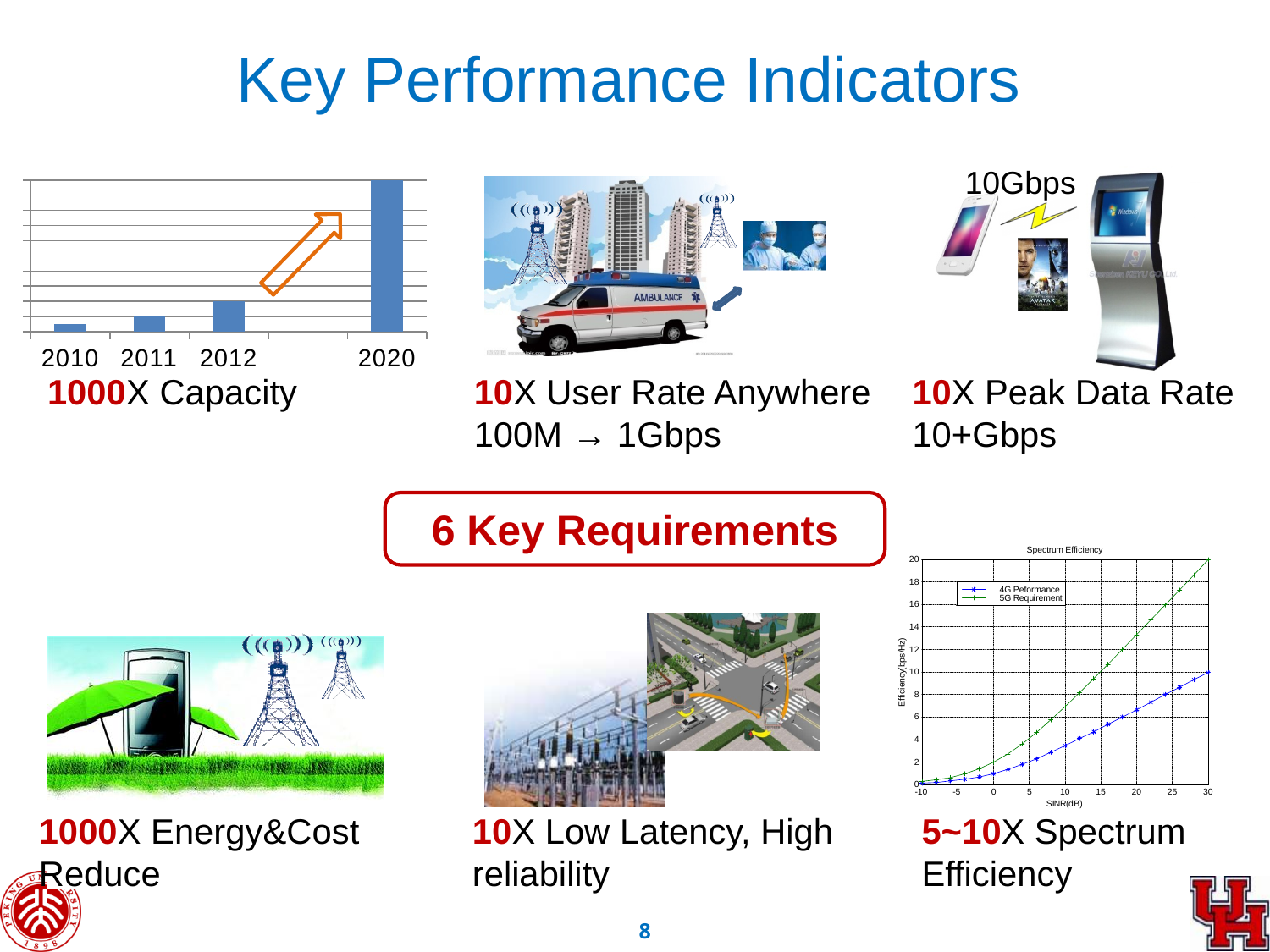
What is the x-axis label of the Spectrum Efficiency chart? SINR(dB) What are the two series named in the legend of the Spectrum Efficiency chart? 4G Peformance and 5G Requirement On the Spectrum Efficiency chart, which series is higher at SINR 30 dB, 4G Peformance or 5G Requirement? 5G Requirement How many series does the legend of the Spectrum Efficiency chart list? 2 What kind of chart is the top-left chart with the years 2010, 2011, 2012 and 2020? bar chart What kind of chart is the Spectrum Efficiency chart at the bottom right? line chart On the top-left bar chart, which year has the shortest bar? 2010 On the top-left bar chart, which year has the tallest bar? 2020 On the top-left bar chart, which bar is taller, 2011 or 2012? 2012 On the top-left bar chart, do the bars rise or fall from 2010 to 2020? rise How many year categories are shown on the top-left bar chart? 4 On the Spectrum Efficiency chart, is the 4G Peformance value at SINR 30 dB greater or less than 15? less